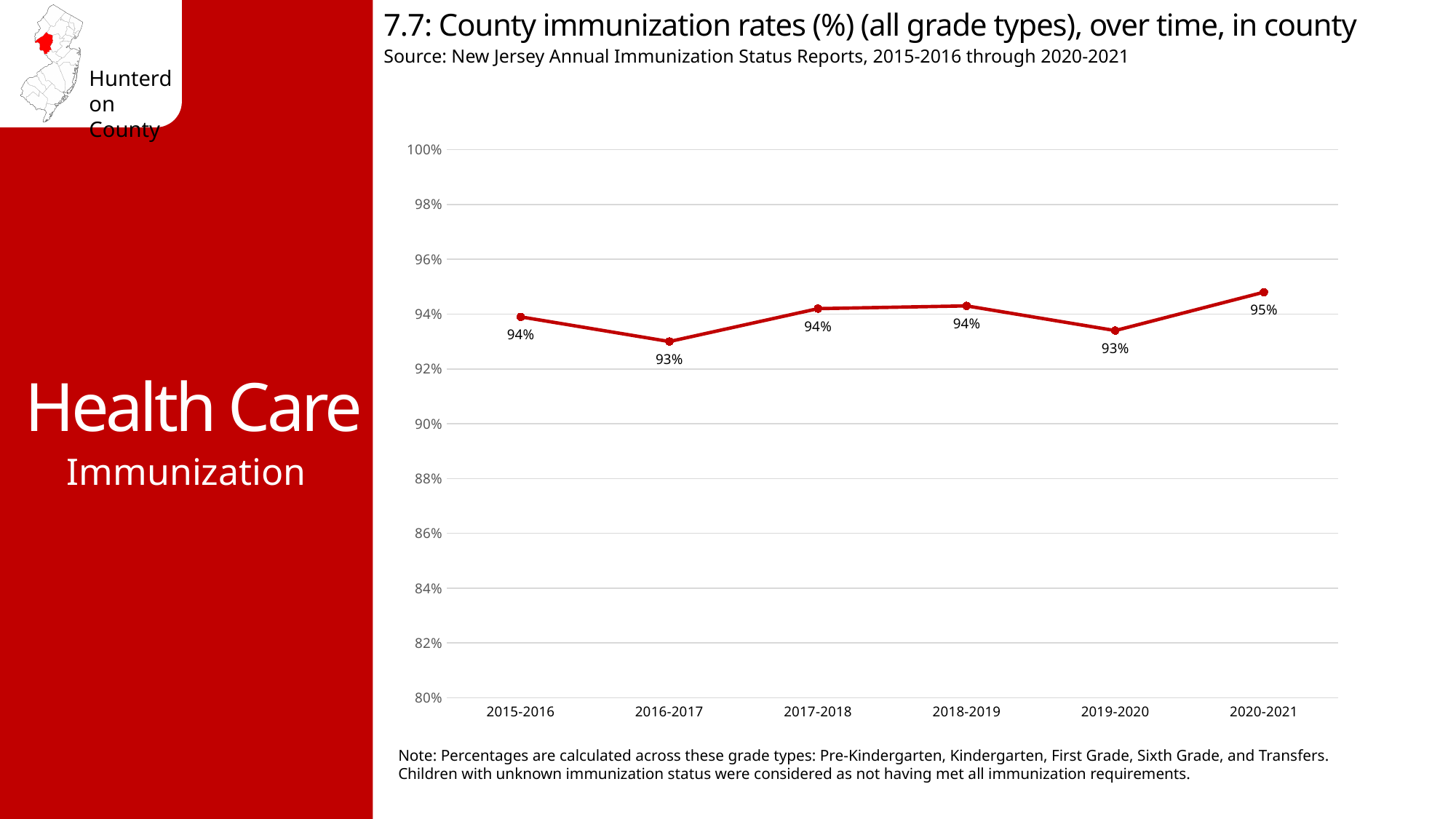
What is the county immunization rate for 2016-2017? 93% Which school year has the highest immunization rate? 2020-2021 What is the county immunization rate for 2019-2020? 93% Does the immunization rate rise or fall from 2019-2020 to 2020-2021? rise What kind of chart is shown on the slide? line chart Which has a higher immunization rate, 2015-2016 or 2016-2017? 2015-2016 What is the county immunization rate for 2015-2016? 94% Is the immunization rate for 2020-2021 greater or less than 94%? greater How many school years are plotted on the chart? 6 What is the county immunization rate for 2020-2021? 95% What is the source cited for the chart data? New Jersey Annual Immunization Status Reports, 2015-2016 through 2020-2021 What is the difference between the immunization rate in 2020-2021 and in 2016-2017? 2%